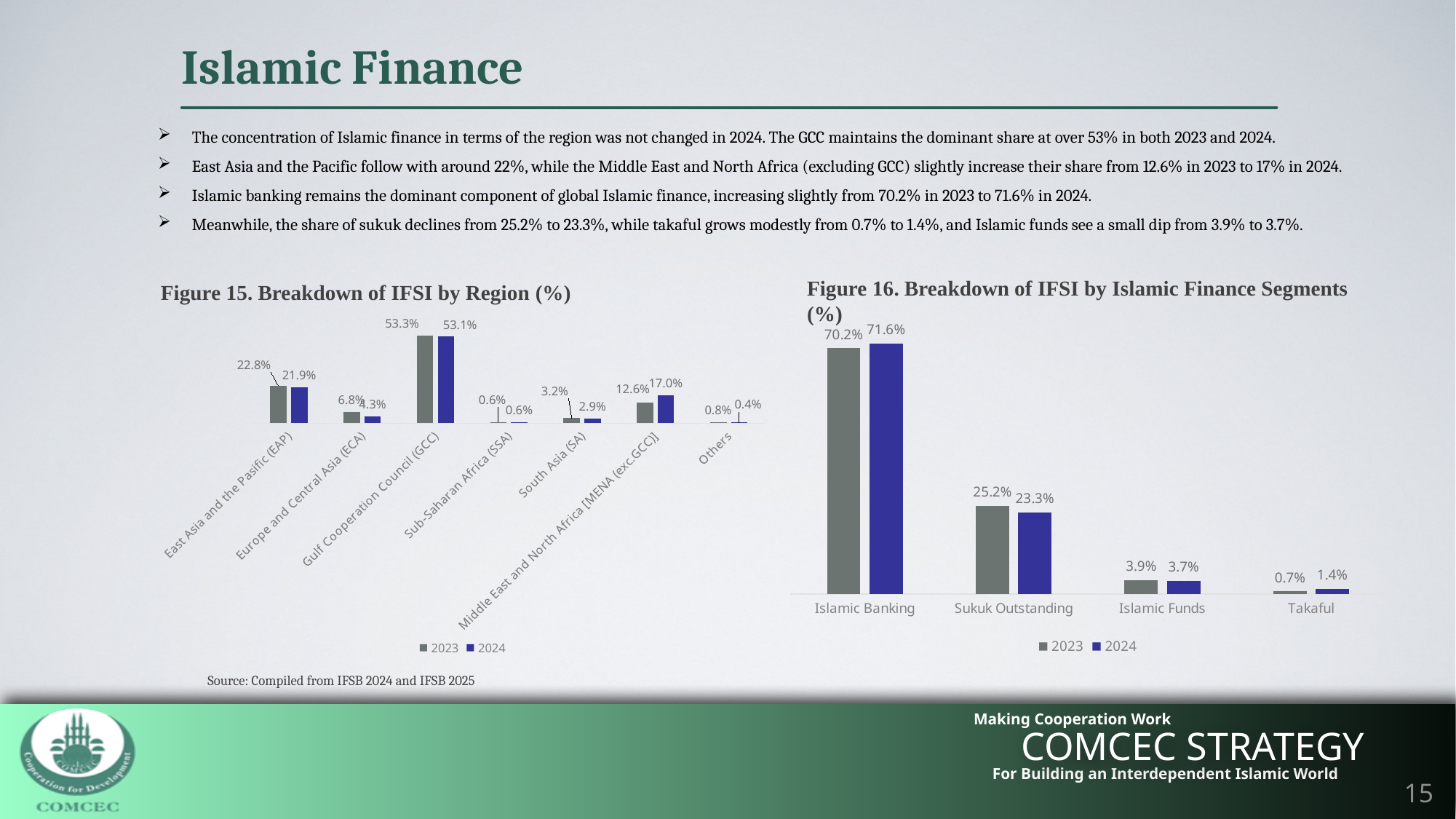
In Figure 15 (Breakdown of IFSI by Region), which is larger: the 2024 value for Europe and Central Asia (ECA) or the 2024 value for South Asia (SA)? Europe and Central Asia (ECA) In Figure 15 (Breakdown of IFSI by Region), what is the 2023 value for East Asia and the Pacific (EAP)? 22.8% In Figure 15 (Breakdown of IFSI by Region), which region has the highest value in 2023? Gulf Cooperation Council (GCC) In Figure 16 (Breakdown of IFSI by Islamic Finance Segments), what is the 2024 value for Islamic Banking? 71.6% In Figure 16 (Breakdown of IFSI by Islamic Finance Segments), what is the 2023 value for Sukuk Outstanding? 25.2% What kind of chart is Figure 16 (Breakdown of IFSI by Islamic Finance Segments)? Bar chart How many series does the legend list in Figure 16 (Breakdown of IFSI by Islamic Finance Segments)? 2 In Figure 16 (Breakdown of IFSI by Islamic Finance Segments), what is the difference between the 2023 and 2024 values for Sukuk Outstanding? 1.9% In Figure 15 (Breakdown of IFSI by Region), what is the difference between the 2023 and 2024 values for Middle East and North Africa [MENA (exc. GCC)]? 4.4% In Figure 15 (Breakdown of IFSI by Region), how many regions are shown on the x axis? 7 In Figure 15 (Breakdown of IFSI by Region), what is the 2024 value for Gulf Cooperation Council (GCC)? 53.1% In Figure 16 (Breakdown of IFSI by Islamic Finance Segments), which segment has the lowest value in 2023? Takaful